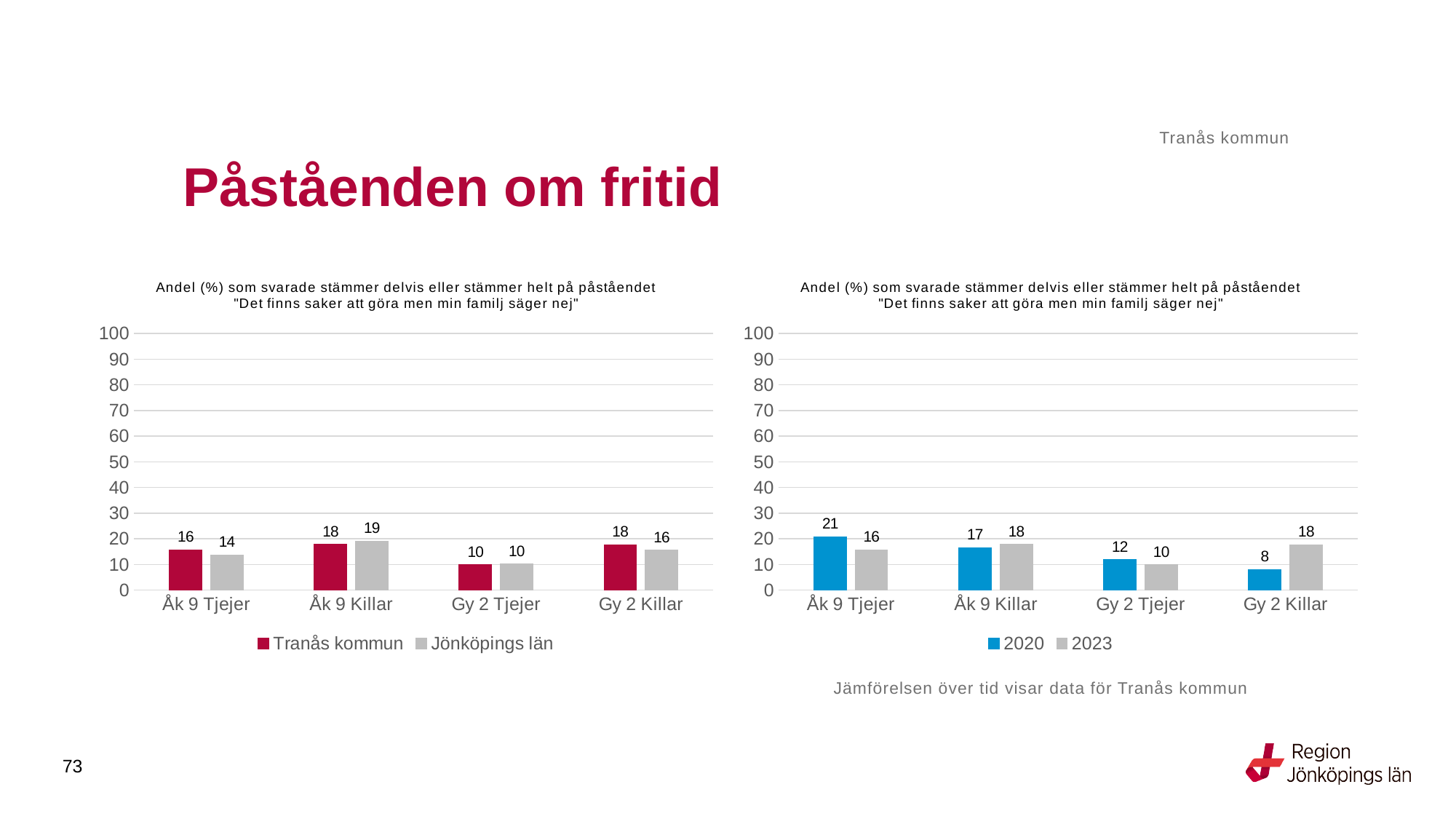
In the right chart, which category has the highest value for 2020? Åk 9 Tjejer In the left chart, what is the value for Tranås kommun for Åk 9 Tjejer? 16 In the left chart, which category has the lowest value for Tranås kommun? Gy 2 Tjejer How many series does the legend of the right chart list? 2 In the right chart, what is the value for 2023 for Åk 9 Tjejer? 16 What kind of chart is the left chart? bar chart In the right chart, is the value for 2020 for Åk 9 Tjejer greater or less than 20? greater In the left chart, what is the value for Jönköpings län for Åk 9 Killar? 19 In the left chart, which is larger for Gy 2 Killar: Tranås kommun or Jönköpings län? Tranås kommun How many categories are shown on the x axis of the left chart? 4 In the right chart, what is the difference between the 2023 and 2020 values for Gy 2 Killar? 10 In the right chart, what is the value for 2020 for Gy 2 Killar? 8